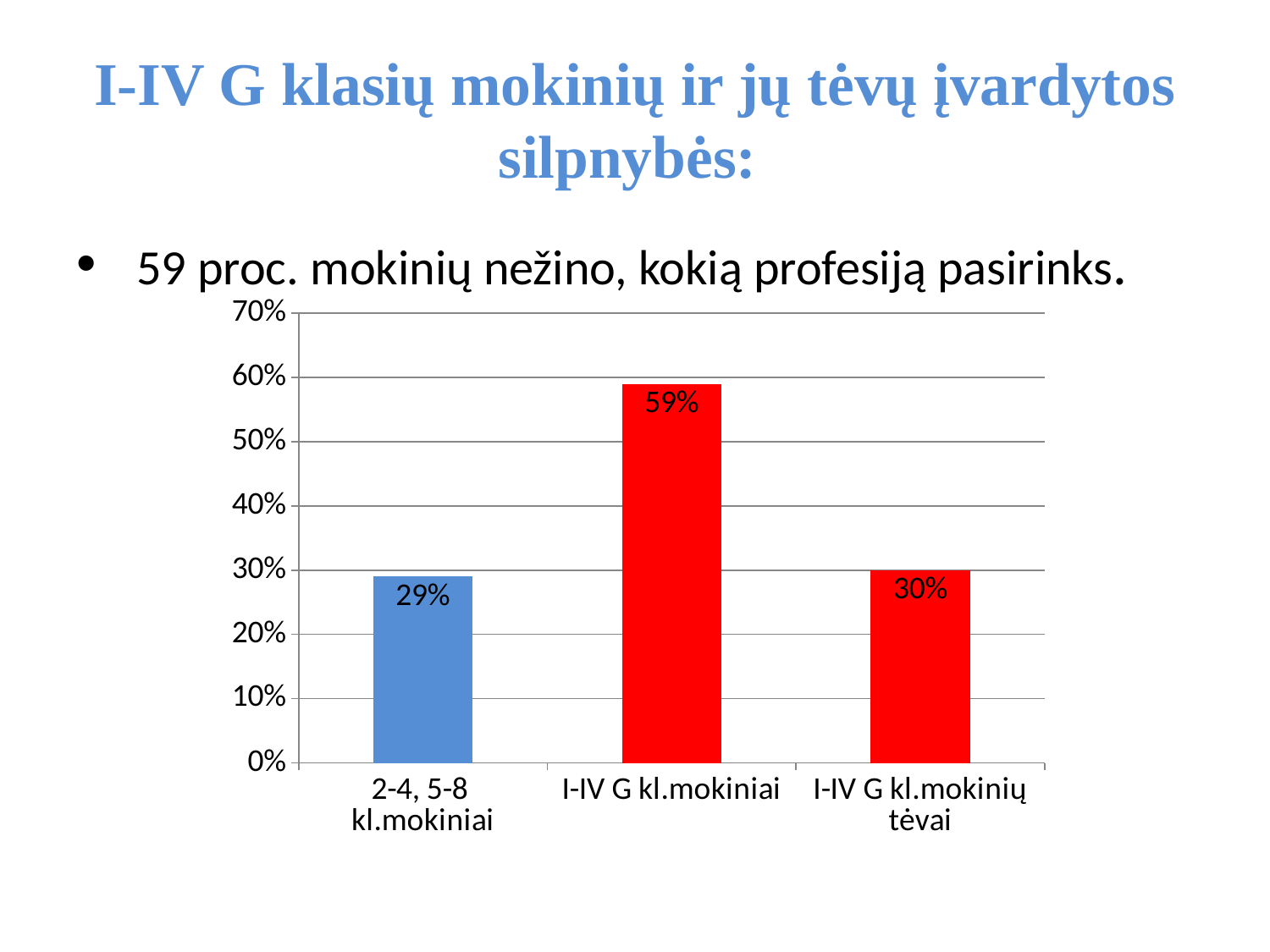
What colour is the bar for "2-4, 5-8 kl.mokiniai"? blue What kind of chart is shown on the slide? bar chart How many categories are shown on the chart? 3 What is the value for "I-IV G kl.mokiniai"? 59% Which is larger: the value for "I-IV G kl.mokiniai" or the value for "I-IV G kl.mokinių tėvai"? I-IV G kl.mokiniai What is the value for "2-4, 5-8 kl.mokiniai"? 29% What is the value for "I-IV G kl.mokinių tėvai"? 30% What is the difference between the values for "I-IV G kl.mokiniai" and "I-IV G kl.mokinių tėvai"? 29% Which category has the lowest value? 2-4, 5-8 kl.mokiniai Which category has the highest value? I-IV G kl.mokiniai Is the value for "I-IV G kl.mokiniai" greater or less than 50%? greater What is the difference between the values for "I-IV G kl.mokiniai" and "2-4, 5-8 kl.mokiniai"? 30%